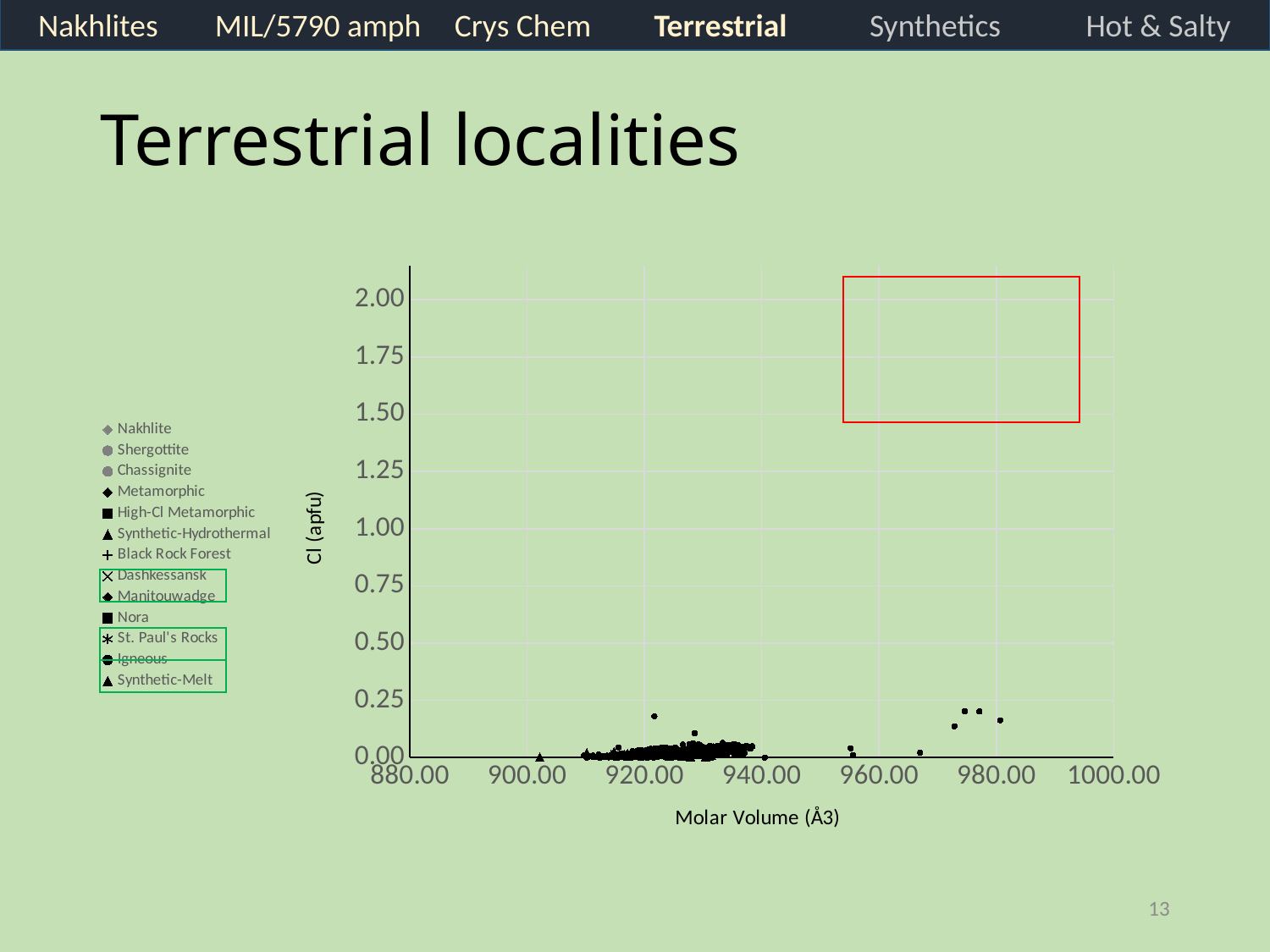
What is the lowest value shown on the x axis? 880.00 What is the title of the slide containing the chart? Terrestrial localities Are the molar volumes of the small group of points at the right of the chart greater or less than 960.00? greater How many series does the chart's legend list? 13 Is the molar volume of the isolated triangle point near the left of the cluster greater or less than 920.00? less Are all the plotted Cl (apfu) values greater or less than 0.25? less What is the highest value shown on the y axis? 2.00 What kind of chart is shown on the slide? Scatter chart